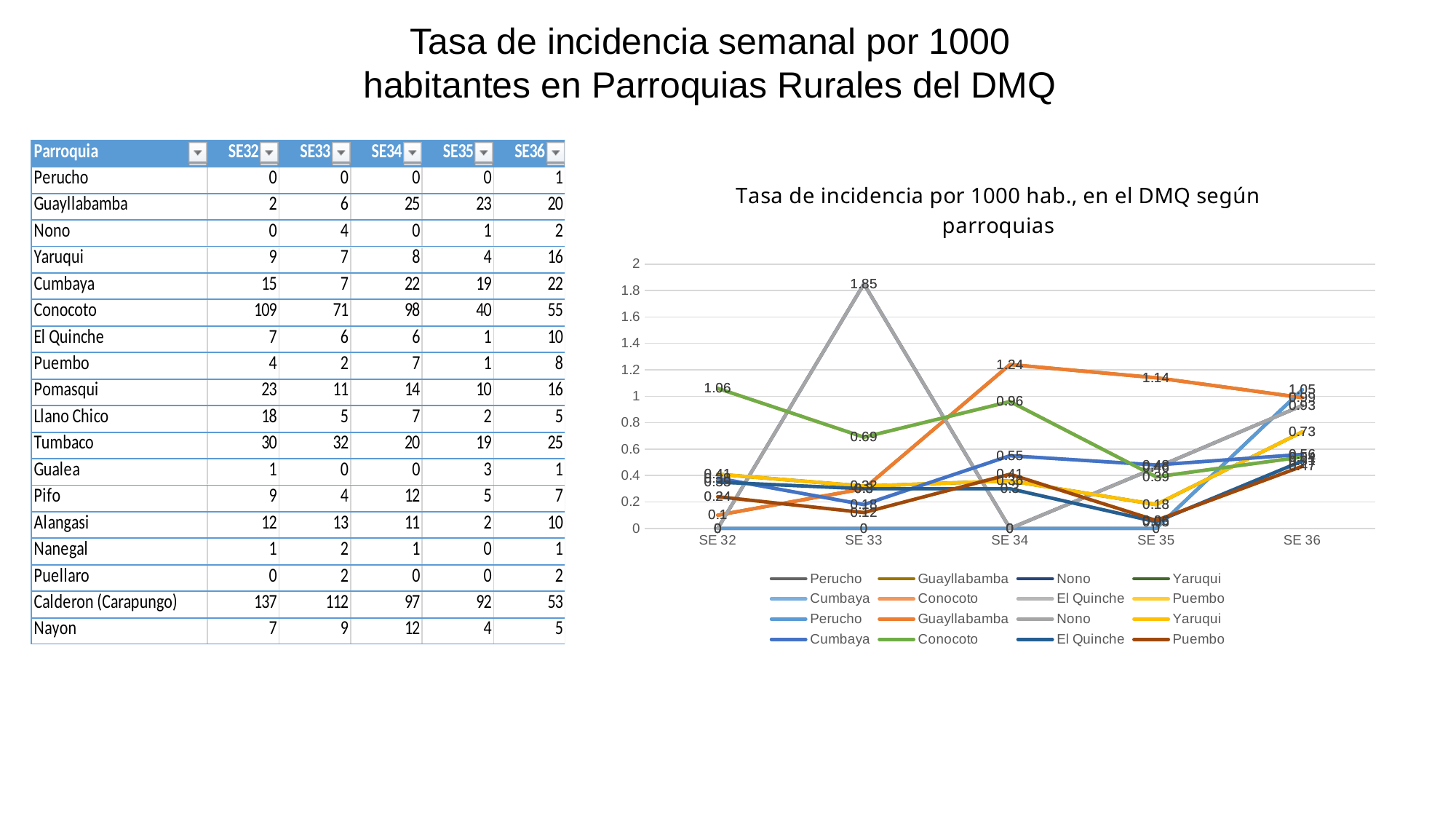
Which is larger: the peak value at SE 33 or the peak value at SE 34? SE 33 What is the highest value labeled at SE 34 on the chart? 1.24 At which week does the chart reach its highest plotted value? SE 33 What kind of chart is shown on the slide? line chart What is the difference between the peak value at SE 33 (1.85) and the peak value at SE 34 (1.24)? 0.61 What is the highest value labeled anywhere on the chart? 1.85 What is the highest value labeled at SE 35 on the chart? 1.14 How many weeks (points) are shown along the x axis of the chart? 5 How many entries does the chart's legend list? 16 What is the highest value labeled at SE 36 on the chart? 1.05 What is the highest value labeled at SE 32 on the chart? 1.06 What is the title of the chart on the right of the slide? Tasa de incidencia por 1000 hab., en el DMQ según parroquias